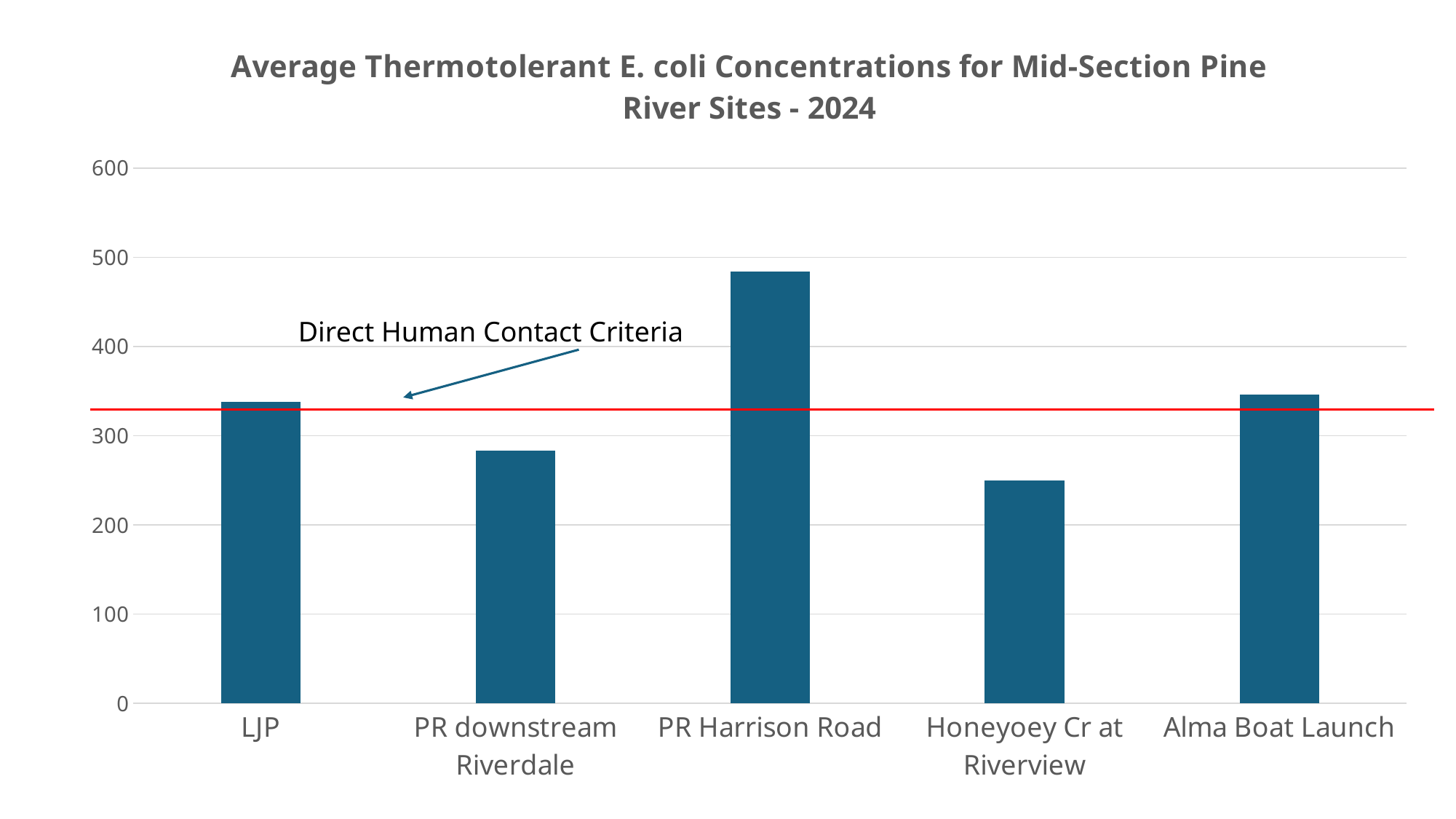
Is the value for LJP greater or less than 300? greater Is the value for PR Harrison Road greater or less than 500? less What is the title of the chart? Average Thermotolerant E. coli Concentrations for Mid-Section Pine River Sites - 2024 How many sites are plotted on the chart? 5 Is the value for PR downstream Riverdale greater or less than 300? less Which site has the lowest average E. coli concentration? Honeyoey Cr at Riverview Which has a higher value, PR downstream Riverdale or Honeyoey Cr at Riverview? PR downstream Riverdale Which site has the highest average E. coli concentration? PR Harrison Road Which has a higher value, PR Harrison Road or PR downstream Riverdale? PR Harrison Road What does the red horizontal line on the chart represent? Direct Human Contact Criteria What kind of chart is shown on the slide? bar chart